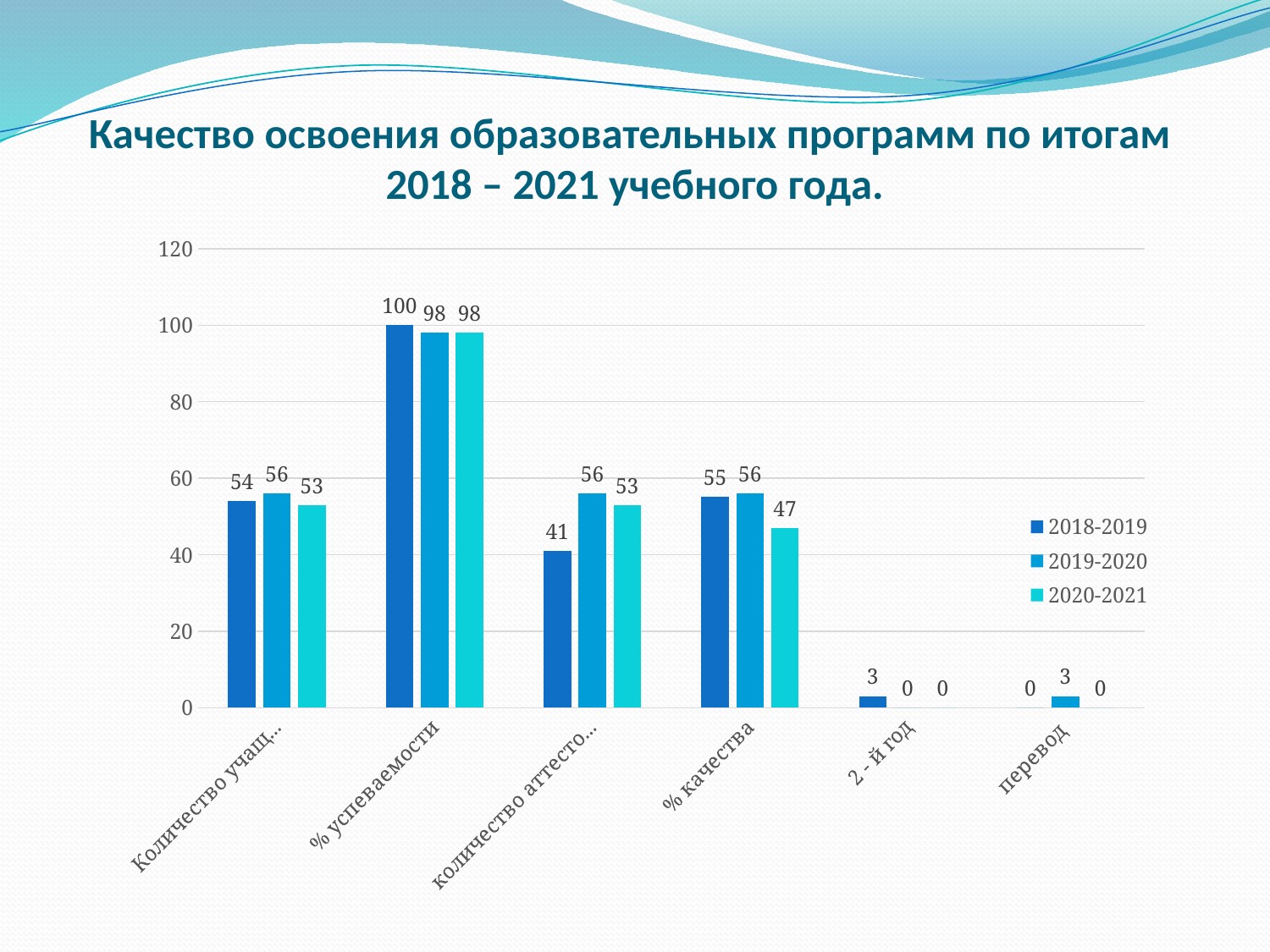
What is the difference between the 2019-2020 and 2020-2021 values in the category "% качества"? 9 What type of chart is shown on the slide? bar chart How many categories are shown on the x axis? 6 How many series does the legend list? 3 What is the title of the chart on the slide? Качество освоения образовательных программ по итогам 2018 – 2021 учебного года. What is the value for 2018-2019 in the category "2 - й год"? 3 What is the value for 2020-2021 in the category "% качества"? 47 In the category "% успеваемости", which is larger: the 2018-2019 value or the 2020-2021 value? 2018-2019 Which series has the highest value in the category "% успеваемости"? 2018-2019 What is the value for 2018-2019 in the category "% успеваемости"? 100 What is the value for 2019-2020 in the category "перевод"? 3 Which series has the lowest value in the category "% качества"? 2020-2021